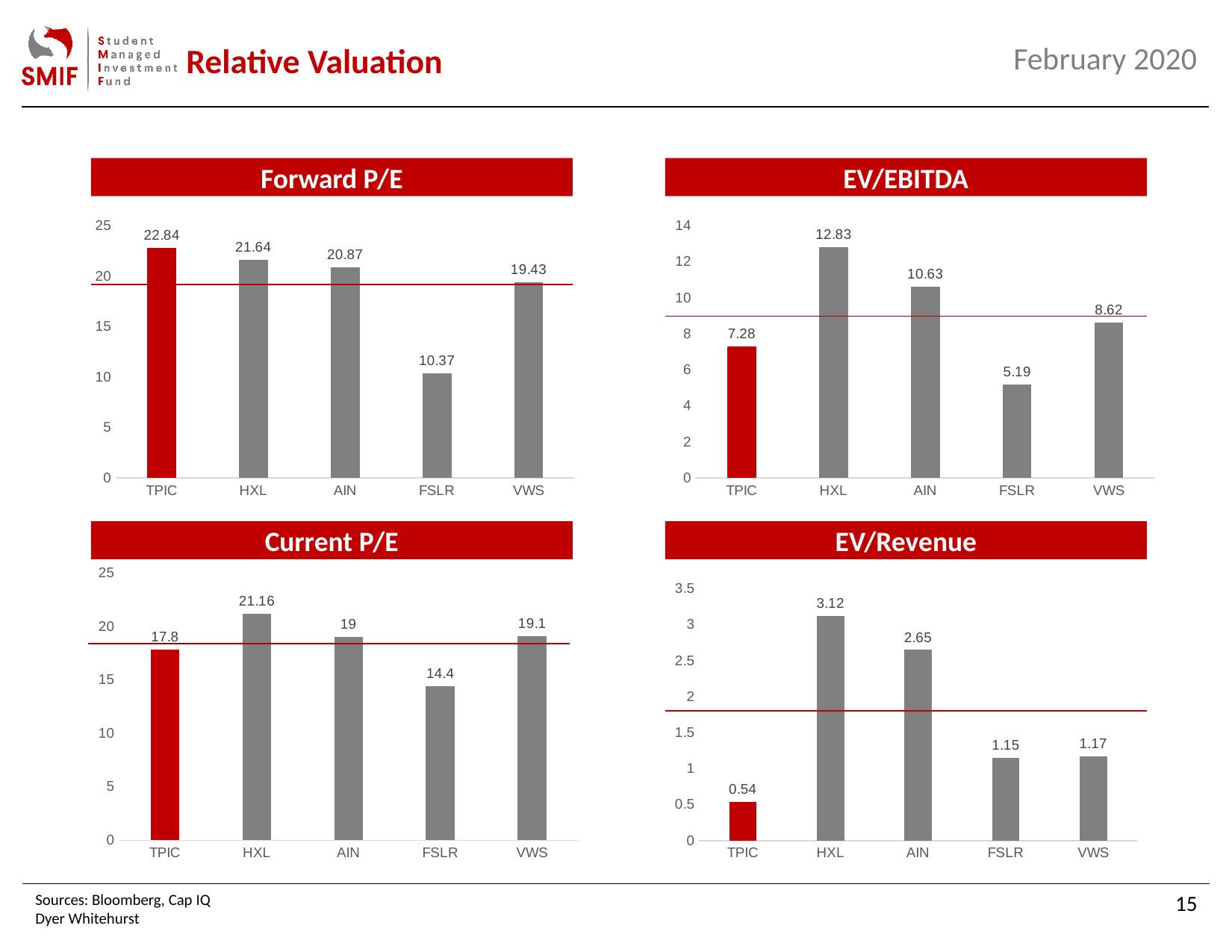
In the Forward P/E chart, what is the value for TPIC? 22.84 In the Current P/E chart, which is larger, the value for HXL or the value for VWS? HXL In the EV/Revenue chart, which company has the lowest value? TPIC In the EV/Revenue chart, what is the value for TPIC? 0.54 What kind of chart is the Current P/E chart? Bar chart In the Current P/E chart, what is the value for FSLR? 14.4 How many companies are shown in the Forward P/E chart? 5 In the EV/EBITDA chart, what is the difference between the values for AIN and FSLR? 5.44 In the EV/EBITDA chart, what is the value for HXL? 12.83 In the EV/EBITDA chart, which company has the highest value? HXL In the EV/Revenue chart, what is the difference between the values for HXL and AIN? 0.47 In the Forward P/E chart, which company has the lowest value? FSLR